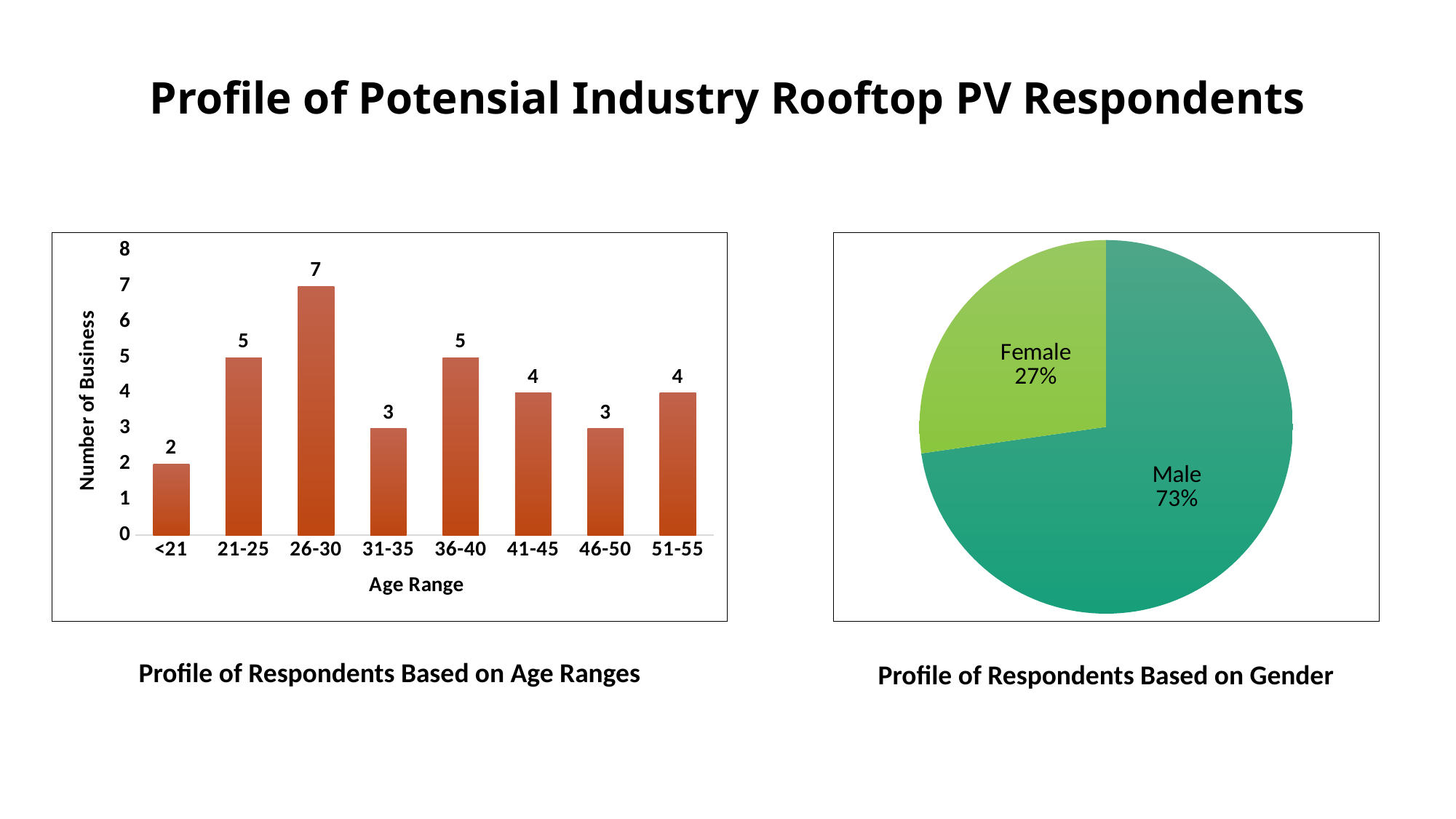
How many age ranges are shown in the 'Profile of Respondents Based on Age Ranges' chart? 8 In the 'Profile of Respondents Based on Age Ranges' chart, what is the difference between the values for 26-30 and 31-35? 4 In the 'Profile of Respondents Based on Age Ranges' chart, what is the number of business for the 26-30 age range? 7 In the 'Profile of Respondents Based on Age Ranges' chart, which has a larger value, 21-25 or 41-45? 21-25 What kind of chart is 'Profile of Respondents Based on Age Ranges'? Bar chart In the 'Profile of Respondents Based on Age Ranges' chart, what is the value for the <21 age range? 2 In the 'Profile of Respondents Based on Gender' chart, what share of respondents are Female? 27% What is the y-axis label of the 'Profile of Respondents Based on Age Ranges' chart? Number of Business In the 'Profile of Respondents Based on Gender' chart, what share of respondents are Male? 73% In the 'Profile of Respondents Based on Age Ranges' chart, which age range has the lowest number of business? <21 In the 'Profile of Respondents Based on Age Ranges' chart, which age range has the highest number of business? 26-30 What kind of chart is 'Profile of Respondents Based on Gender'? Pie chart